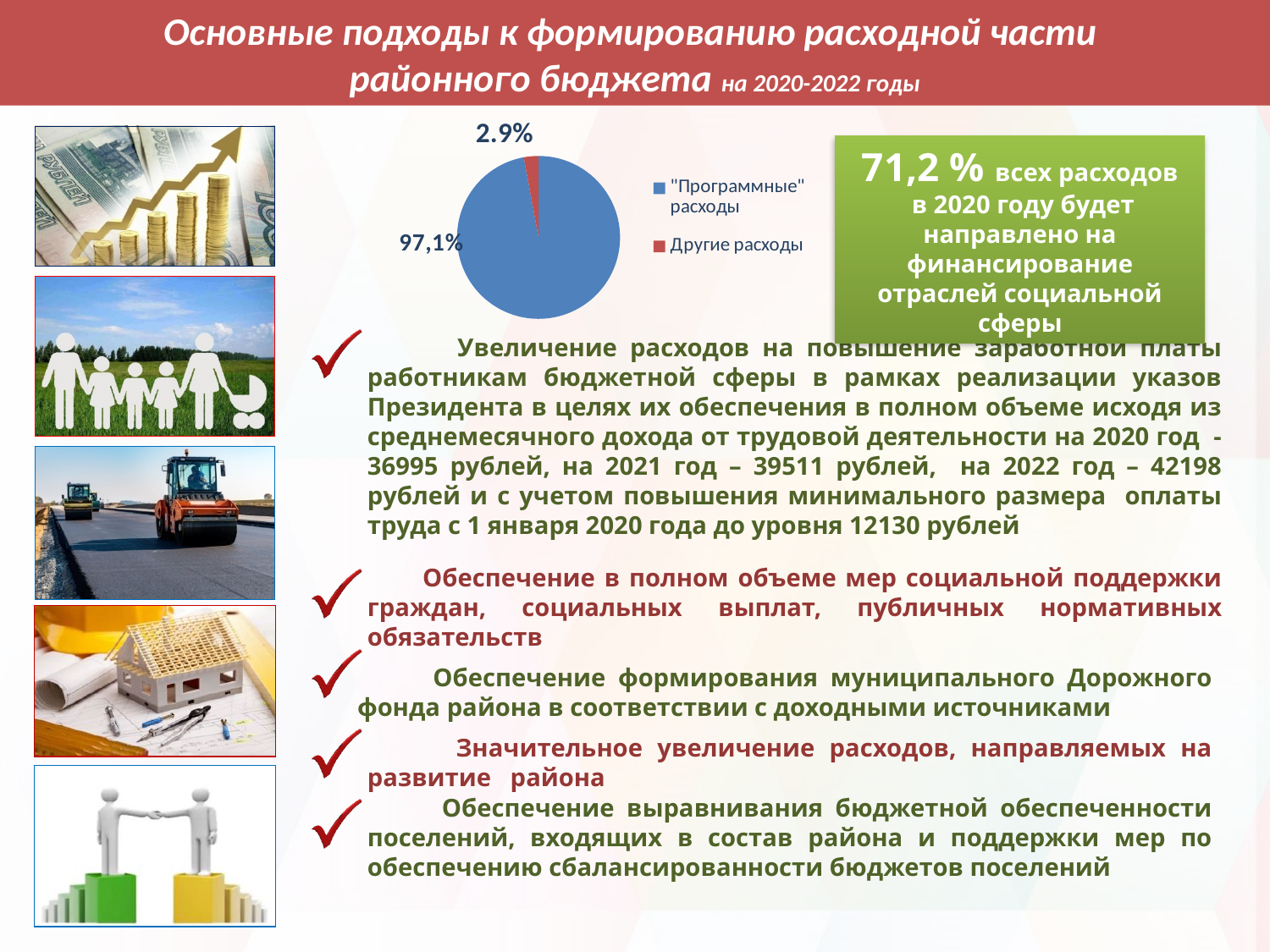
Which category has the largest slice in the pie chart? "Программные" расходы How many entries does the legend of the pie chart list? 2 What kind of chart is shown on the slide? pie chart How many slices does the pie chart have? 2 Which is larger in the pie chart: "Программные" расходы or Другие расходы? "Программные" расходы Which category has the smallest slice in the pie chart? Другие расходы What colour is the slice for Другие расходы in the pie chart? red What share of the pie chart is labelled for "Программные" расходы? 97,1% What share of the pie chart is labelled for Другие расходы? 2.9% What colour is the slice for "Программные" расходы in the pie chart? blue